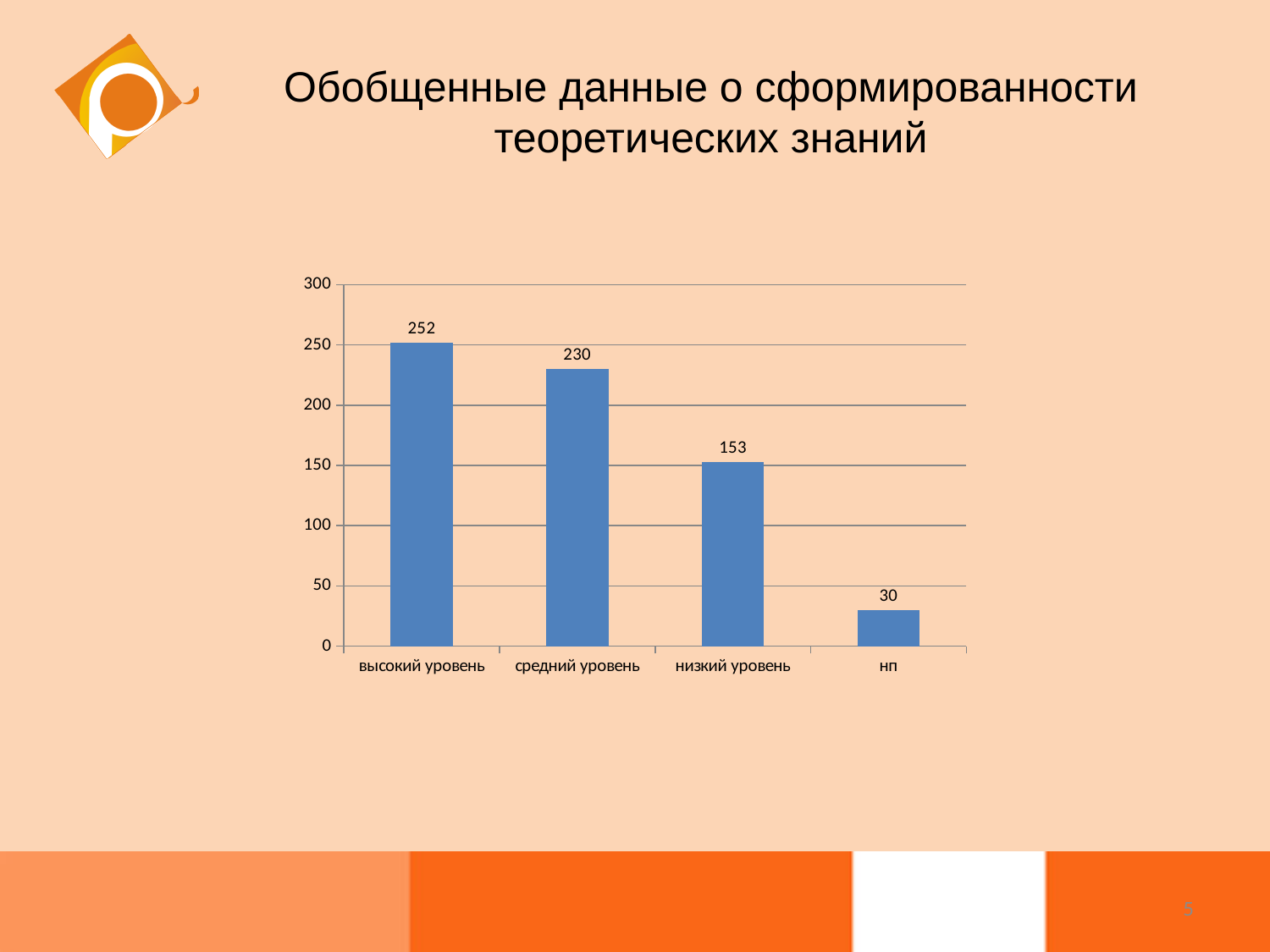
Is the value for низкий уровень greater or less than 200? less What is the value for высокий уровень? 252 What is the value for средний уровень? 230 What is the difference between the values for высокий уровень and средний уровень? 22 Which category has the lowest value? нп Which category has the highest value? высокий уровень How many categories are shown on the x axis? 4 What is the value for нп? 30 What kind of chart is shown on the slide? bar chart What is the difference between the values for низкий уровень and нп? 123 What is the value for низкий уровень? 153 Which is larger, the value for средний уровень or the value for низкий уровень? средний уровень